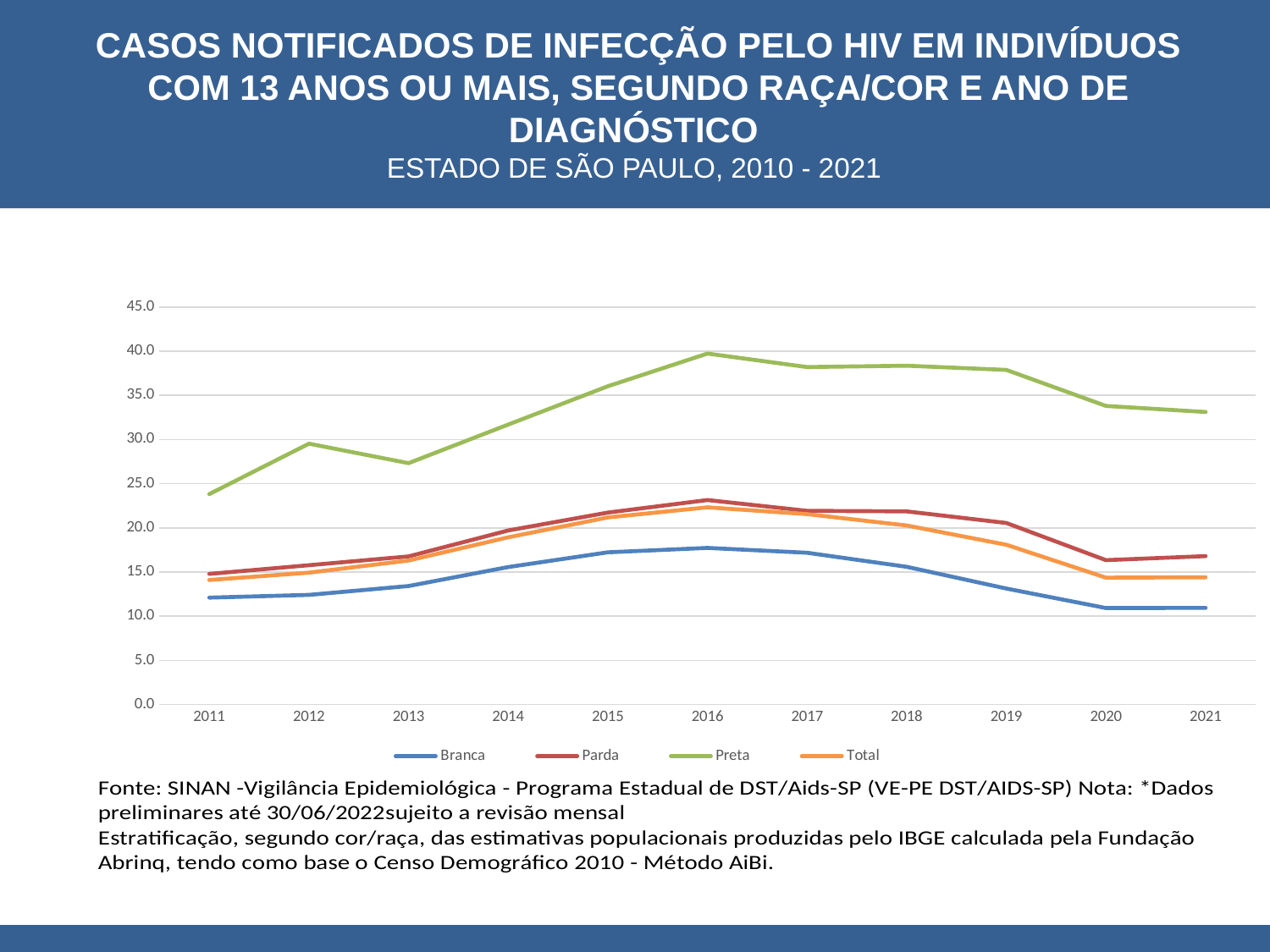
Is the value for Preta in 2020 greater or less than 35.0? less Which is larger in 2016, the value for Preta or the value for Branca? Preta What kind of chart is shown on the slide? line chart How many years are plotted along the x axis? 11 Which colour is used for the Preta series in the legend? green Which series has the highest values across all years? Preta In which year does the Preta series reach its highest value? 2016 Is the value for Branca in 2016 greater or less than 15.0? greater Which series has the lowest values across all years? Branca Is the value for Preta in 2016 greater or less than 35.0? greater How many series does the legend list? 4 Do the values for Preta rise or fall from 2016 to 2021? fall